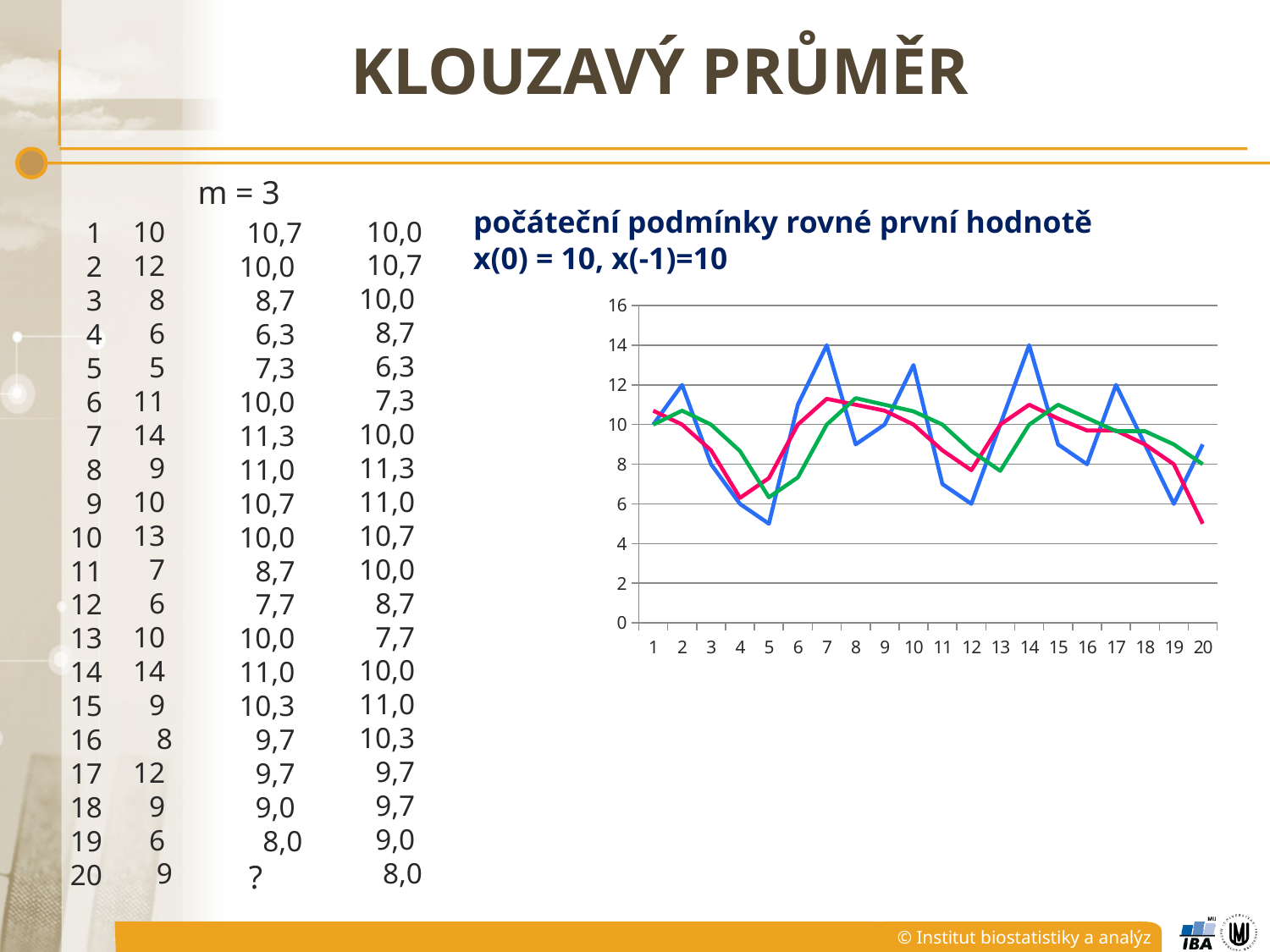
At which x value does the red line reach its lowest point? 20 What is the highest value shown on the chart's y axis? 16 Is the value of the blue line at x = 10 greater or less than 12? greater What is the value of the blue line at x = 7? 14 Does the blue line rise or fall between x = 2 and x = 5? fall What is the value of the blue line at x = 2? 12 Is the value of the green line at x = 5 greater or less than 8? less At x = 20, which line is higher, the blue line or the red line? blue What kind of chart is shown on the slide? line chart How many points are labelled along the x axis of the chart? 20 How many lines are plotted in the chart? 3 Is the value of the red line at x = 20 greater or less than 6? less